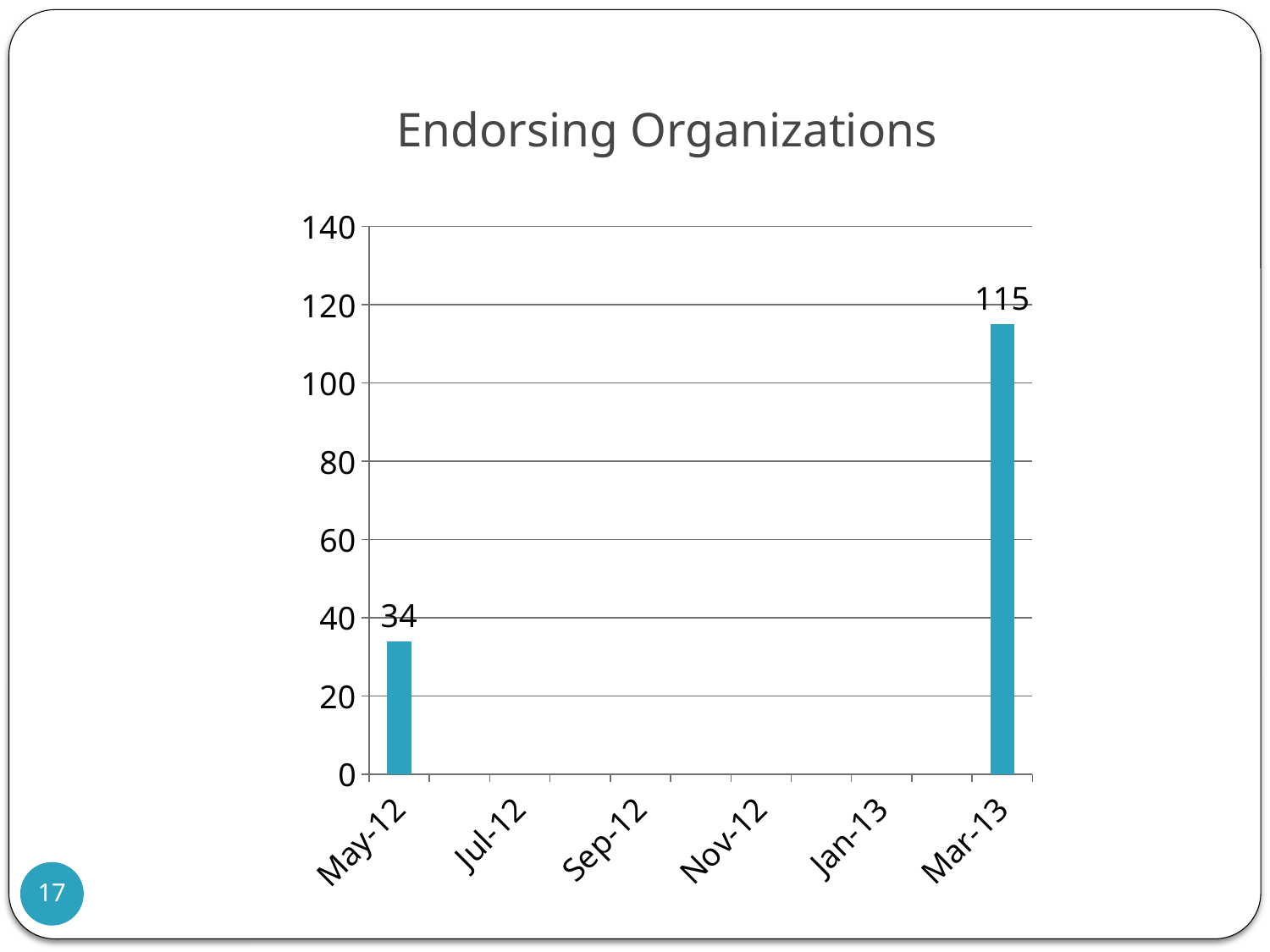
Do the values rise or fall from May-12 to Mar-13? rise What is the difference between the values for Mar-13 and May-12? 81 Is the value for May-12 greater or less than 40? less Which is larger, the value for May-12 or the value for Mar-13? Mar-13 Is the value for Mar-13 greater or less than 100? greater Which of the two plotted bars has the lowest value? May-12 What is the value for May-12? 34 What is the title of the chart? Endorsing Organizations What kind of chart is shown? bar chart What is the value for Mar-13? 115 How many bars are plotted on the chart? 2 Which category has the highest value? Mar-13